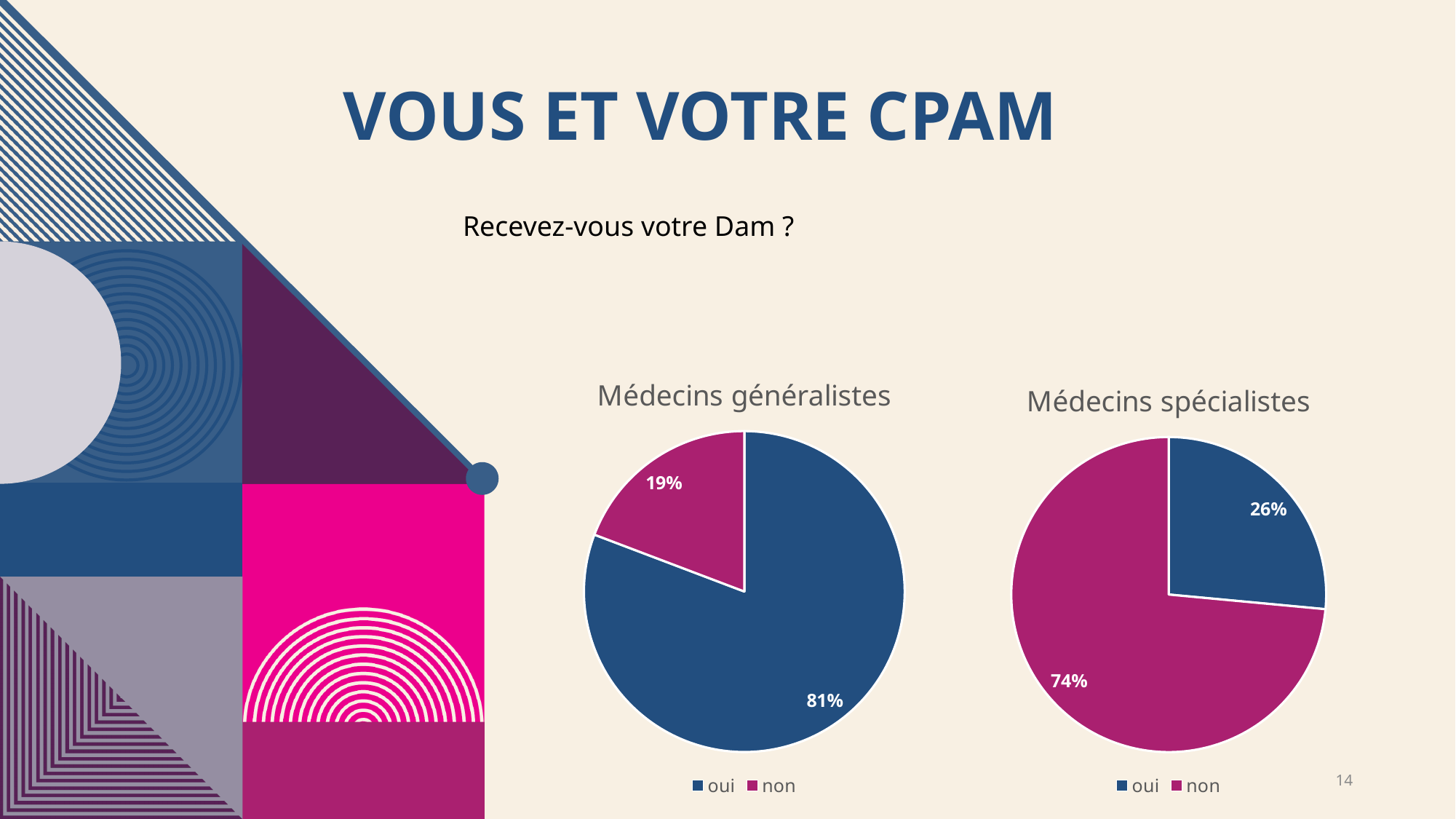
In the 'Médecins spécialistes' chart, what share of respondents answered 'non'? 74% In the 'Médecins généralistes' chart, what is the difference between the 'oui' and 'non' shares? 62% What are the legend entries of the 'Médecins spécialistes' chart? oui, non In the 'Médecins généralistes' chart, what share of respondents answered 'non'? 19% How many slices does the 'Médecins généralistes' pie chart have? 2 What type of chart is the 'Médecins spécialistes' chart? Pie chart In the 'Médecins spécialistes' chart, what is the difference between the 'non' and 'oui' shares? 48% In the 'Médecins spécialistes' chart, which answer has the smallest slice? oui In the 'Médecins généralistes' chart, what share of respondents answered 'oui'? 81% In the 'Médecins spécialistes' chart, what share of respondents answered 'oui'? 26% Which chart shows a larger 'oui' share, 'Médecins généralistes' or 'Médecins spécialistes'? Médecins généralistes In the 'Médecins généralistes' chart, which answer has the largest slice? oui